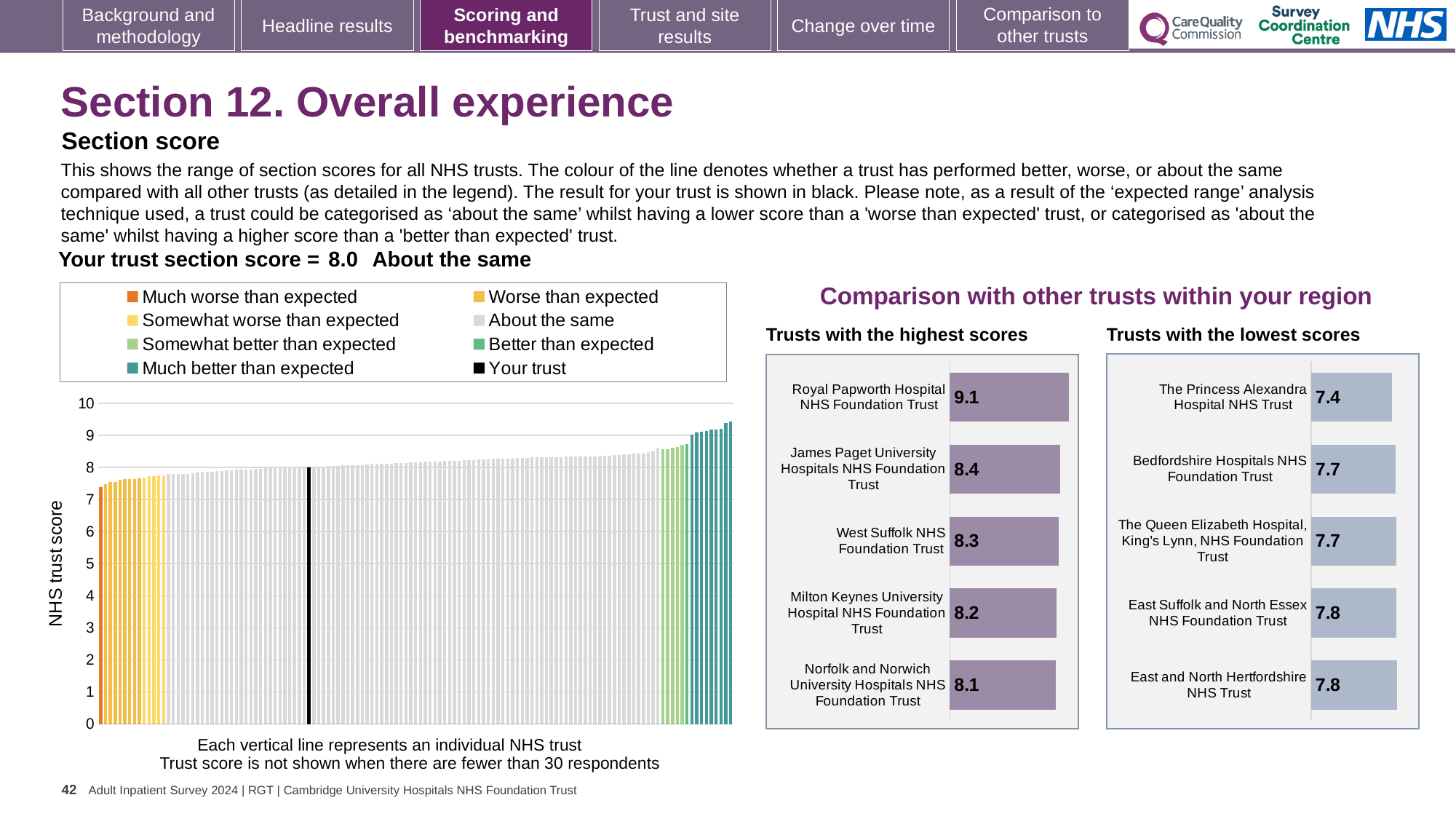
In the 'Trusts with the lowest scores' chart, what is the score for East and North Hertfordshire NHS Trust? 7.8 In the main chart on the left, do the trust scores rise or fall from left to right? Rise How many entries does the legend of the main chart on the left list? 8 In the 'Trusts with the highest scores' chart, which trust has the lowest score shown? Norfolk and Norwich University Hospitals NHS Foundation Trust What kind of chart is the main chart on the left showing NHS trust scores? Bar chart In the main chart on the left, what is the section score for your trust? 8.0 In the 'Trusts with the lowest scores' chart, what is the score for The Princess Alexandra Hospital NHS Trust? 7.4 In the 'Trusts with the lowest scores' chart, which has the higher score: Bedfordshire Hospitals NHS Foundation Trust or East Suffolk and North Essex NHS Foundation Trust? East Suffolk and North Essex NHS Foundation Trust In the 'Trusts with the lowest scores' chart, which trust has the lowest score? The Princess Alexandra Hospital NHS Trust In the 'Trusts with the highest scores' chart, what is the difference between the scores of Royal Papworth Hospital NHS Foundation Trust and James Paget University Hospitals NHS Foundation Trust? 0.7 How many trusts are shown in the 'Trusts with the highest scores' chart? 5 In the 'Trusts with the highest scores' chart, what is the score for Royal Papworth Hospital NHS Foundation Trust? 9.1